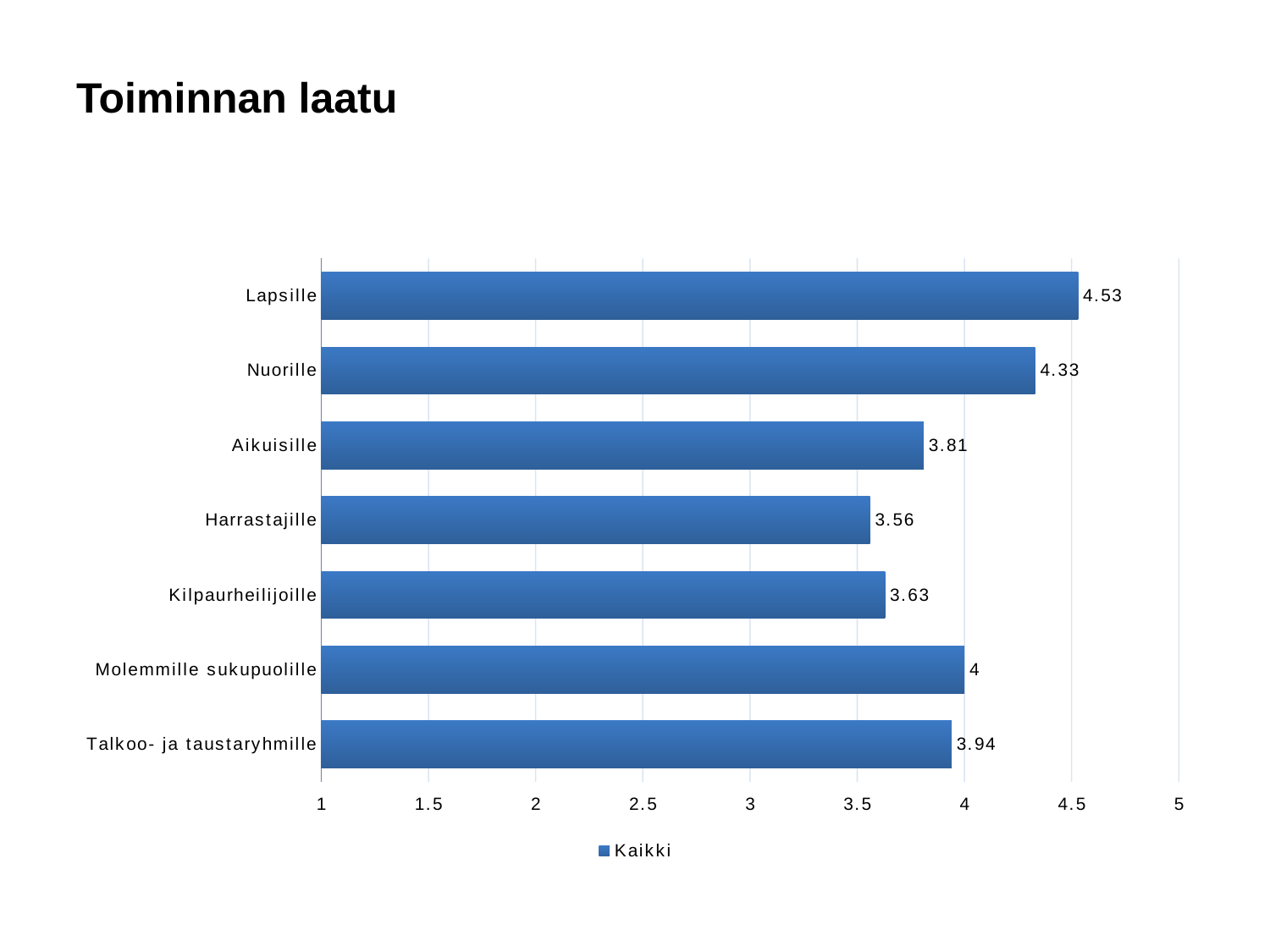
Is the value for Nuorille greater or less than 4? greater What is the value for Talkoo- ja taustaryhmille? 3.94 What is the value for Kilpaurheilijoille? 3.63 What is the value for Lapsille? 4.53 Which category has the highest value? Lapsille Which is larger, the value for Aikuisille or the value for Harrastajille? Aikuisille How many series does the legend list? 1 Which category has the lowest value? Harrastajille What kind of chart is shown on the slide? bar chart What is the difference between the values for Lapsille and Nuorille? 0.2 How many categories are shown in the chart? 7 What is the difference between the values for Molemmille sukupuolille and Aikuisille? 0.19